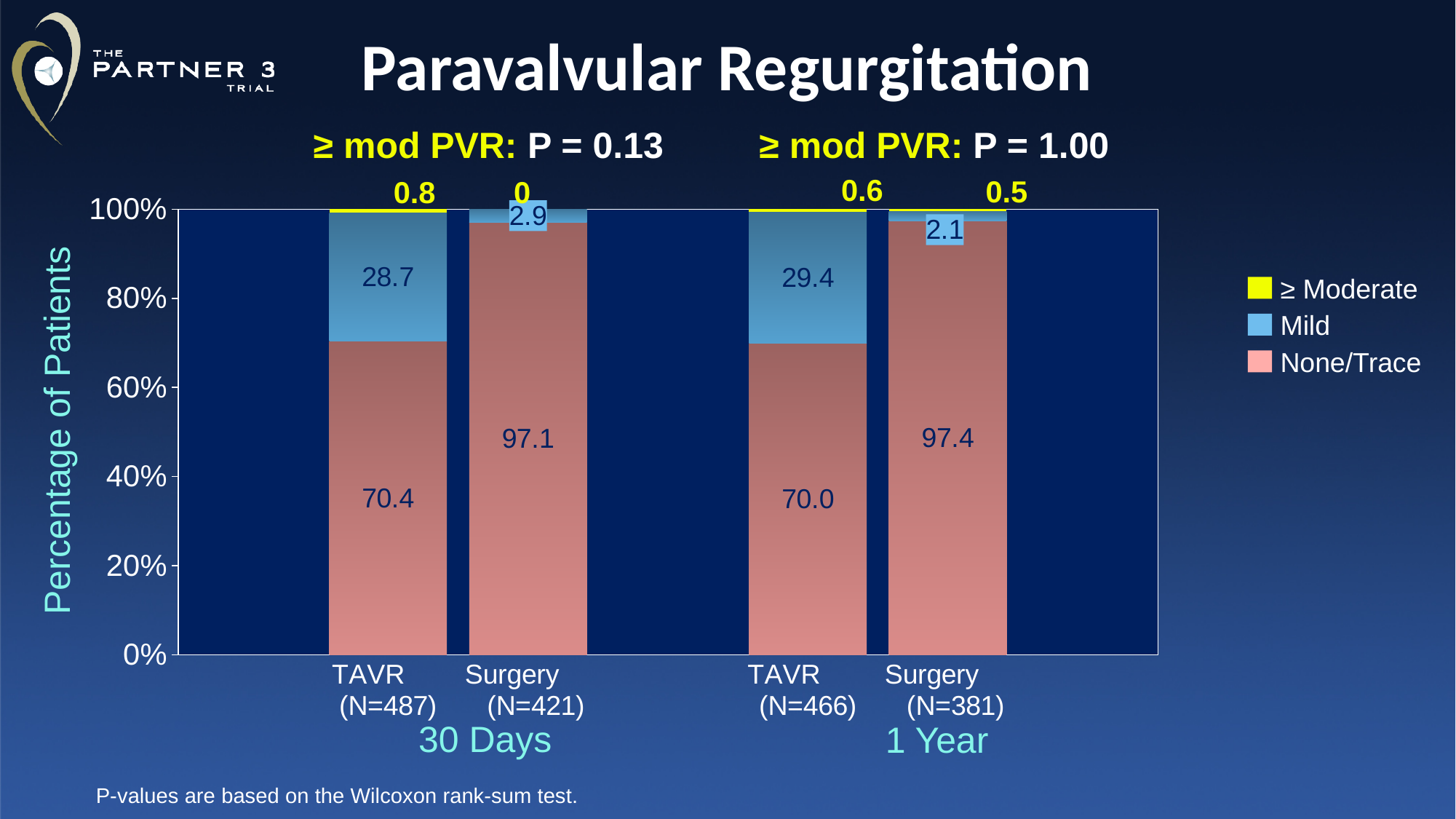
What is the None/Trace value for Surgery (N=381) at 1 Year? 97.4 Which bar has the lowest Mild value? Surgery (N=381) at 1 Year Which bar has the highest None/Trace value? Surgery (N=381) at 1 Year What is the None/Trace value for TAVR (N=487) at 30 Days? 70.4 How many series does the legend list? 3 What is the ≥ Moderate value for TAVR (N=466) at 1 Year? 0.6 Which is larger, the None/Trace value for TAVR at 30 Days or for TAVR at 1 Year? TAVR at 30 Days How many bars are plotted in the chart? 4 What kind of chart is shown on the slide? Stacked bar chart What is the Mild value for Surgery (N=421) at 30 Days? 2.9 What is the difference between the Mild values for TAVR at 1 Year and TAVR at 30 Days? 0.7 What is the ≥ Moderate value for Surgery (N=421) at 30 Days? 0